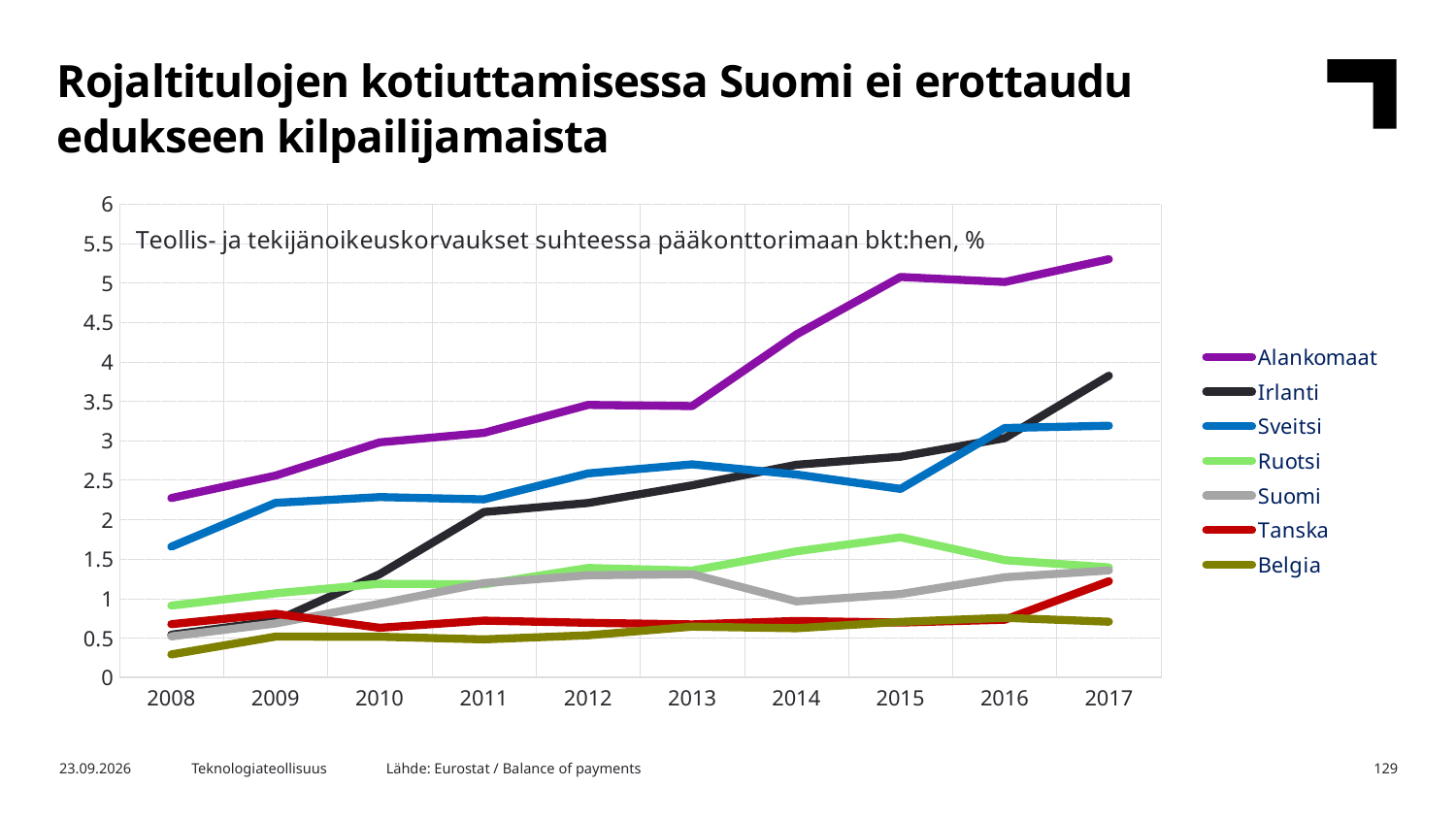
Which country has the lowest value in 2008? Belgia Is the value for Ruotsi in 2015 greater or less than 1.5? greater Is the value for Irlanti in 2008 greater or less than 1? less Does the value for Alankomaat generally rise or fall from 2008 to 2017? Rise What type of chart is shown on the slide? Line chart What colour is the line for Suomi? Grey How many years are shown on the x axis? 10 Is the value for Alankomaat in 2017 greater or less than 5? greater In 2015, which is larger: the value for Irlanti or the value for Sveitsi? Irlanti How many series does the legend list? 7 Which country has the highest value in 2017? Alankomaat In 2017, which is larger: the value for Tanska or the value for Belgia? Tanska